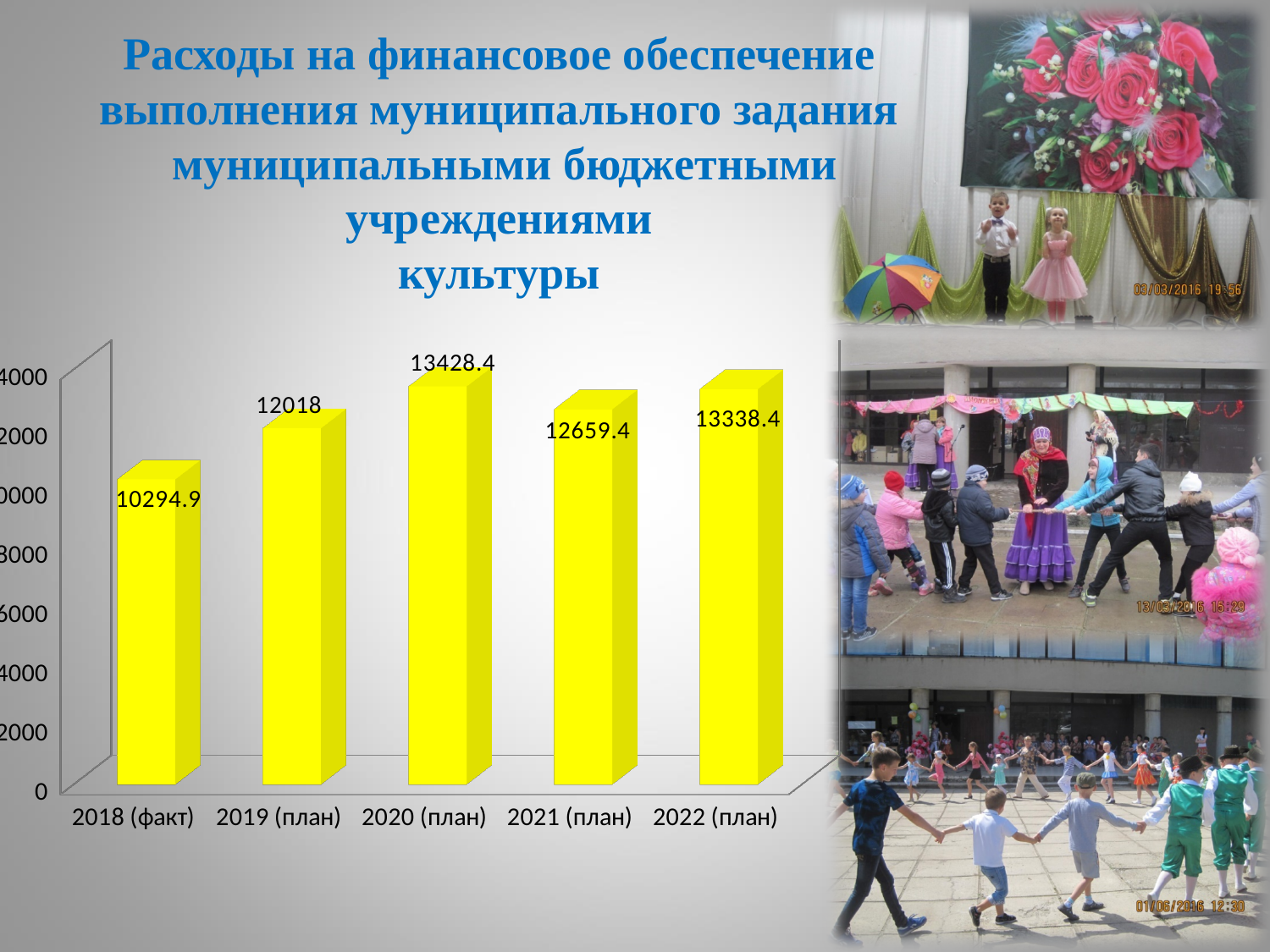
What is the value for 2021 (план)? 12659.4 How many categories are shown on the x axis? 5 Which category has the lowest value? 2018 (факт) What is the value for 2022 (план)? 13338.4 Which is larger, the value for 2019 (план) or the value for 2021 (план)? 2021 (план) What kind of chart is shown on the slide? Bar chart What is the difference between the values for 2020 (план) and 2018 (факт)? 3133.5 Does the value rise or fall from 2020 (план) to 2021 (план)? Fall What is the value for 2018 (факт)? 10294.9 What is the value for 2020 (план)? 13428.4 What is the difference between the values for 2022 (план) and 2021 (план)? 679 Which category has the highest value? 2020 (план)